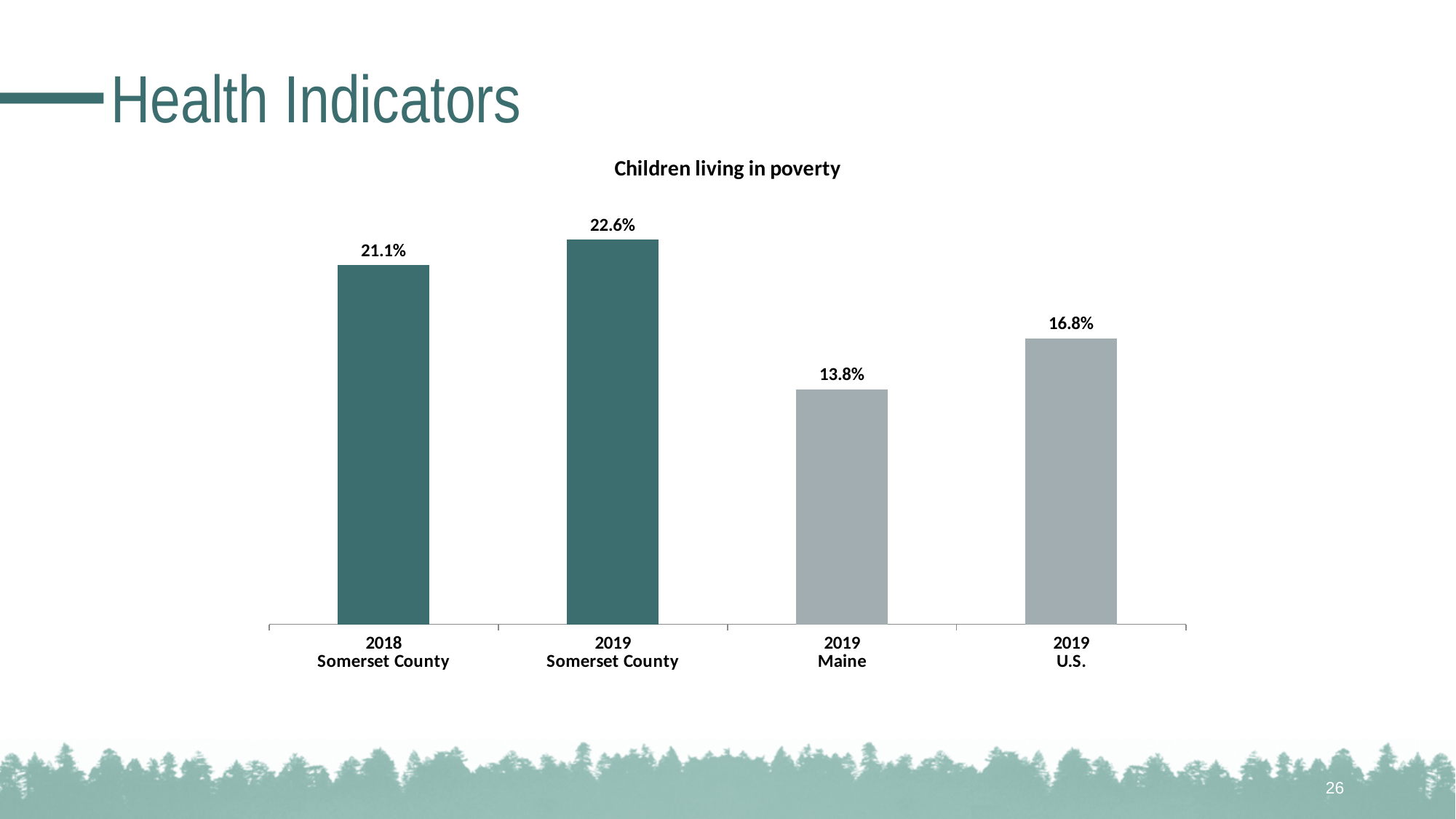
Which is larger, the value for 2019 U.S. or the value for 2019 Maine? 2019 U.S. What is the value for 2019 Somerset County? 22.6% How many bars are shown in the chart? 4 What kind of chart is shown on the slide? Bar chart Which category has the highest value? 2019 Somerset County Which category has the lowest value? 2019 Maine What is the difference between the 2019 Somerset County value and the 2019 Maine value? 8.8% What is the title of the chart? Children living in poverty What is the value for 2019 U.S.? 16.8% What is the value for 2019 Maine? 13.8% What is the value for 2018 Somerset County? 21.1% What is the difference between the 2019 Somerset County value and the 2018 Somerset County value? 1.5%